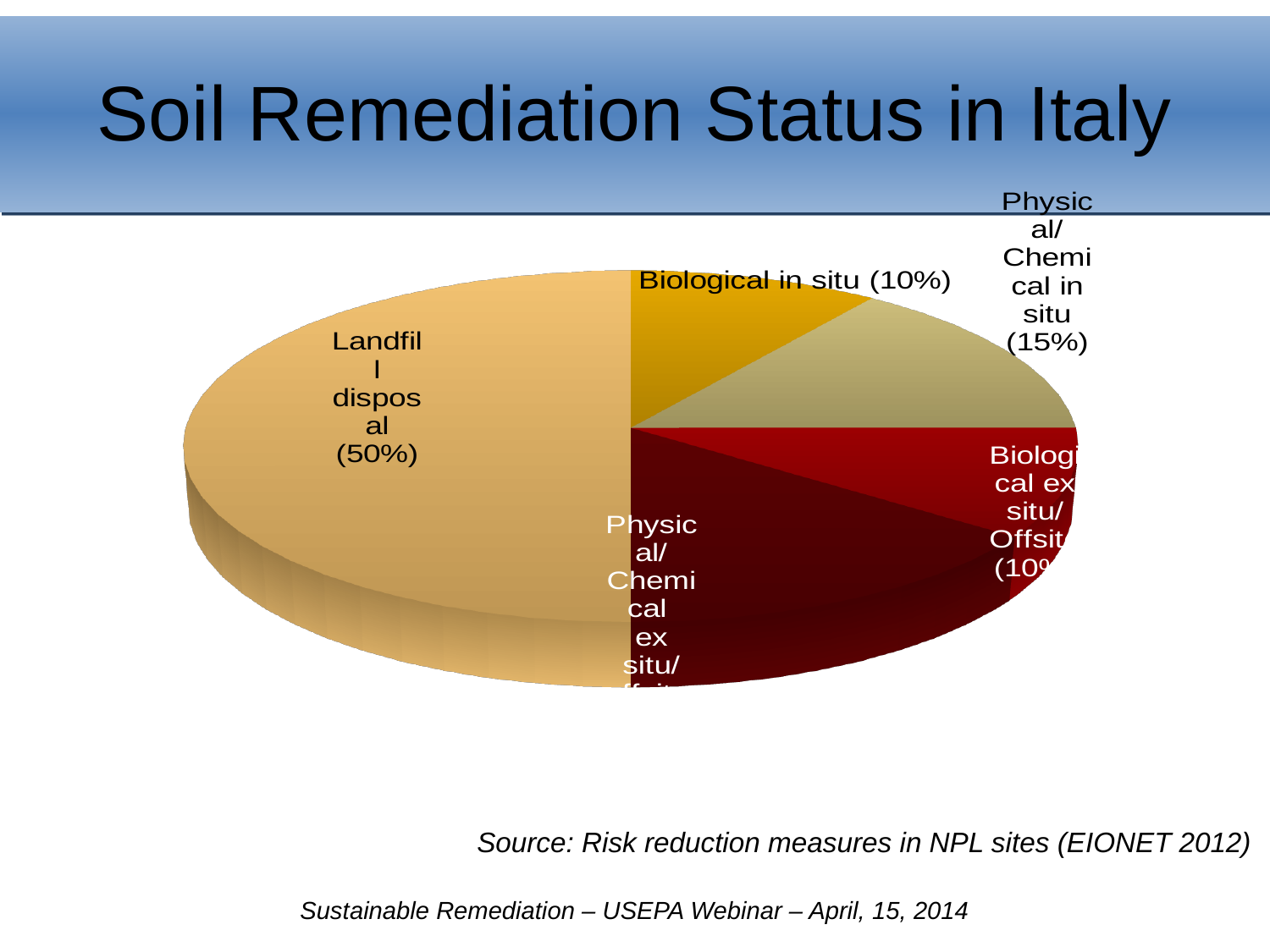
What kind of chart is shown on the slide? Pie chart What source is cited for the chart data? Risk reduction measures in NPL sites (EIONET 2012) What is the value shown for Physical/Chemical in situ? 15% What is the value shown for Biological in situ? 10% What is the title of the slide containing the chart? Soil Remediation Status in Italy What is the difference in percentage points between Landfill disposal and Biological in situ? 40 percentage points Which is larger, Landfill disposal or Physical/Chemical in situ? Landfill disposal How many slices does the pie chart have? 5 What share of the pie does Landfill disposal account for? 50% Which category has the largest slice of the pie? Landfill disposal What is the difference in percentage points between Landfill disposal and Physical/Chemical in situ? 35 percentage points Which is larger, Physical/Chemical in situ or Biological in situ? Physical/Chemical in situ